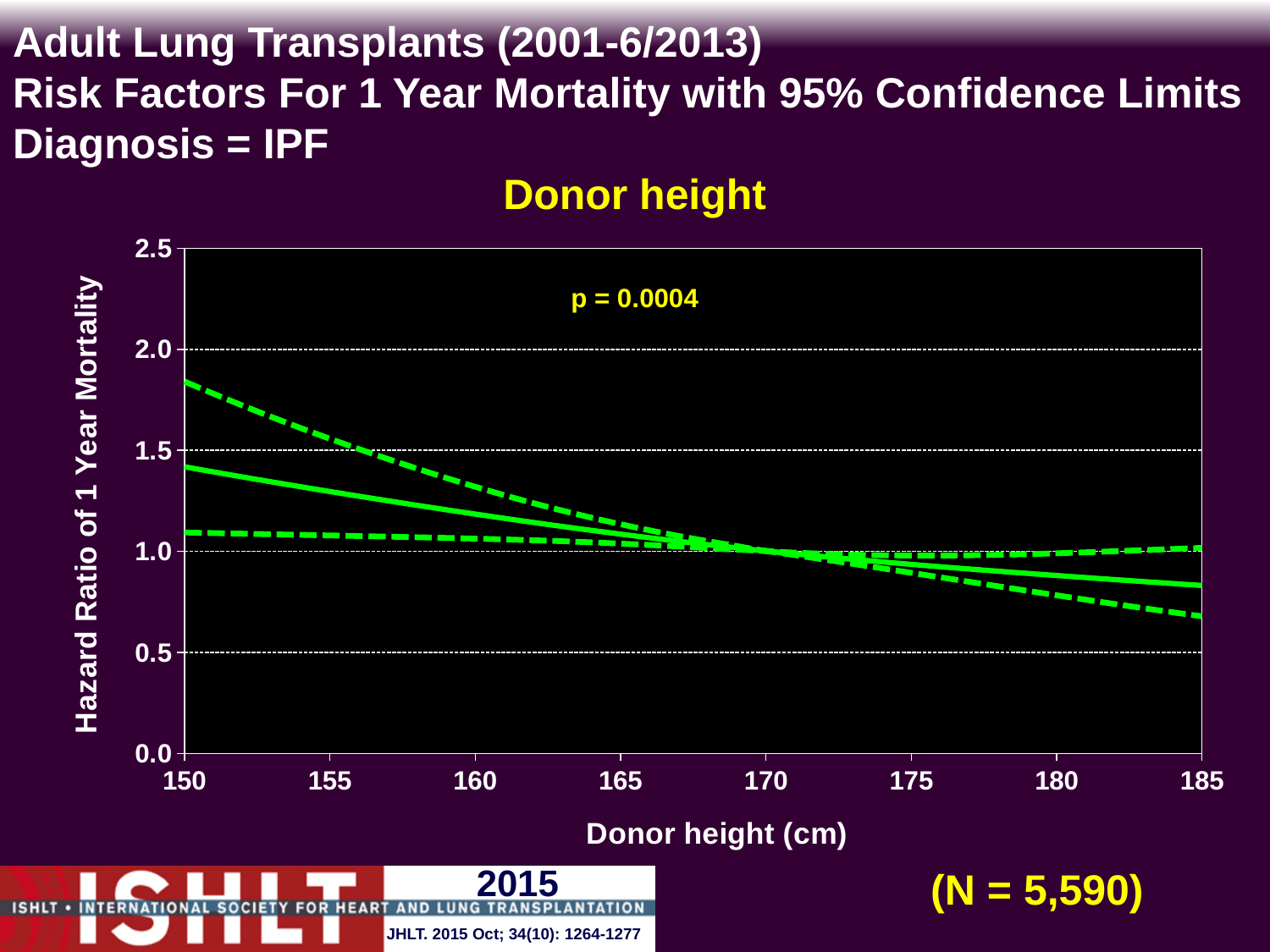
Is the hazard ratio (solid line) at a donor height of 150 cm greater or less than 1.5? less Is the hazard ratio higher at a donor height of 150 cm or at 185 cm? 150 cm How many lines are plotted on the chart? 3 Is the lower 95% confidence limit (lower dashed line) at a donor height of 185 cm greater or less than 0.5? greater What p-value is printed on the chart? p = 0.0004 What is the label of the y axis of the chart? Hazard Ratio of 1 Year Mortality Is the upper 95% confidence limit (upper dashed line) at a donor height of 150 cm greater or less than 1.5? greater How many tick labels are shown on the x axis of the chart? 8 Does the hazard ratio (solid line) rise or fall as donor height increases from 150 cm to 185 cm? fall What kind of chart is shown on the slide? line chart